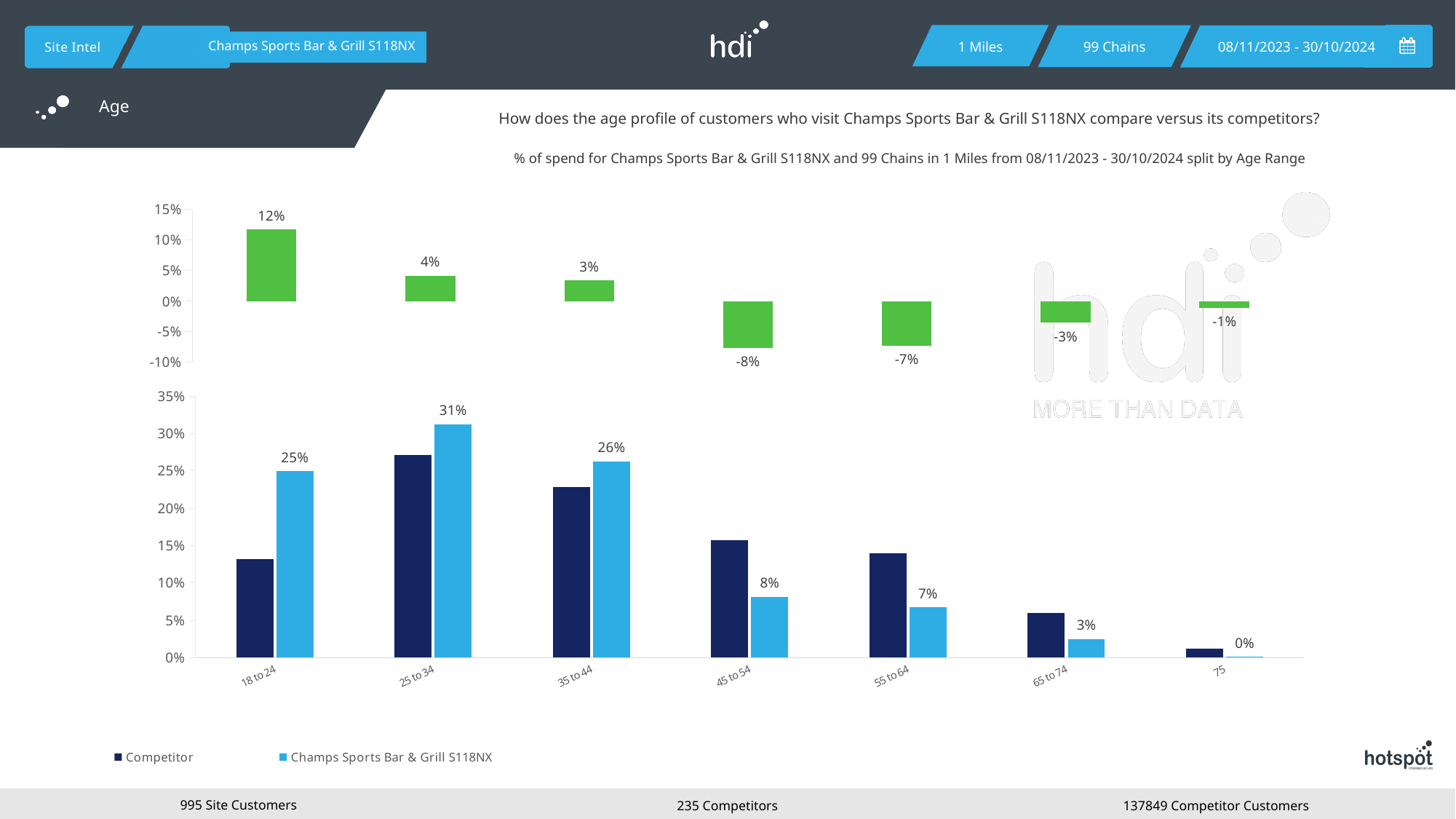
What kind of chart is the bottom chart? bar chart In the top chart, which age range has the lowest value? 45 to 54 In the top chart, which age range has the highest value? 18 to 24 How many age range categories are shown in the bottom chart? 7 In the bottom chart, which age range has the highest value for Champs Sports Bar & Grill S118NX? 25 to 34 How many series does the legend of the bottom chart list? 2 In the bottom chart, what is the difference between the Champs Sports Bar & Grill S118NX values for 25 to 34 and 35 to 44? 5% In the bottom chart, what is the value for Champs Sports Bar & Grill S118NX in the 25 to 34 age range? 31% In the bottom chart, is the Competitor value for 25 to 34 greater or less than 25%? greater In the bottom chart, for the 45 to 54 age range, which is larger: Competitor or Champs Sports Bar & Grill S118NX? Competitor In the top chart, what is the value for the 18 to 24 age range? 12% In the bottom chart, which age range has the lowest value for Champs Sports Bar & Grill S118NX? 75